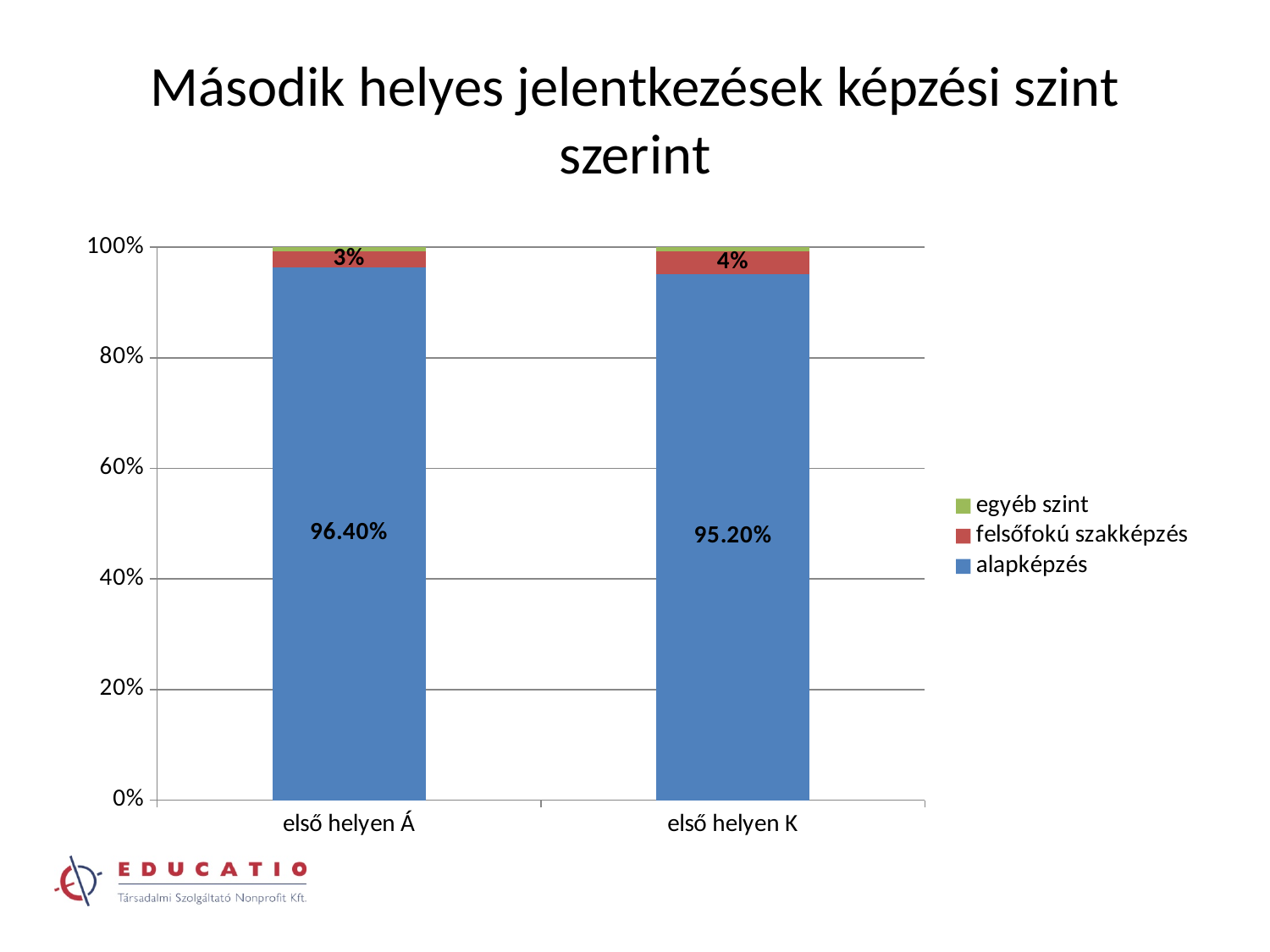
Which category has the higher felsőfokú szakképzés share, első helyen Á or első helyen K? első helyen K Is the alapképzés value for első helyen K greater or less than 80%? greater What is the value for alapképzés in the első helyen Á bar? 96.40% What kind of chart is shown on the slide? stacked bar chart How many series does the legend list? 3 What is the difference between the alapképzés values for első helyen Á and első helyen K? 1.20% Which series is shown in blue in the legend? alapképzés How many categories are shown on the x axis? 2 What is the value for felsőfokú szakképzés in the első helyen Á bar? 3% Which category has the higher alapképzés share, első helyen Á or első helyen K? első helyen Á What is the value for felsőfokú szakképzés in the első helyen K bar? 4% What is the value for alapképzés in the első helyen K bar? 95.20%